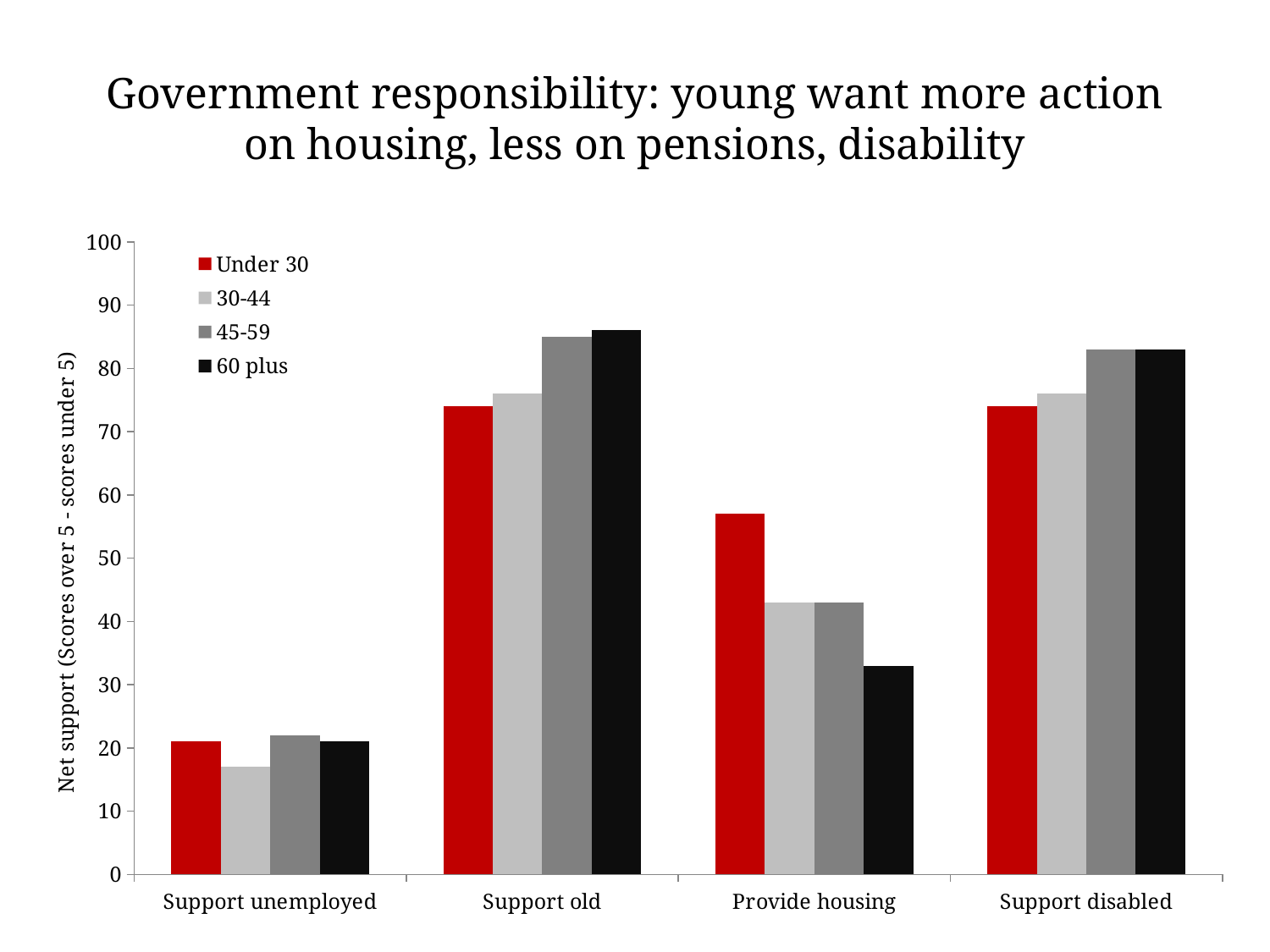
How many categories are shown on the x axis? 4 Which category has the lowest value for the 60 plus series? Support unemployed In the Provide housing category, which is larger: the value for Under 30 or the value for 60 plus? Under 30 What is the label on the vertical axis? Net support (Scores over 5 - scores under 5) Is the value for 45-59 in the Support old category greater or less than 80? greater Is the value for 60 plus in the Provide housing category greater or less than 40? less In the Provide housing category, which age group has the lowest value? 60 plus In the Support old category, which is larger: the value for 30-44 or the value for 45-59? 45-59 How many series does the legend list? 4 Is the value for 30-44 in the Support unemployed category greater or less than 20? less What kind of chart is shown on the slide? Bar chart